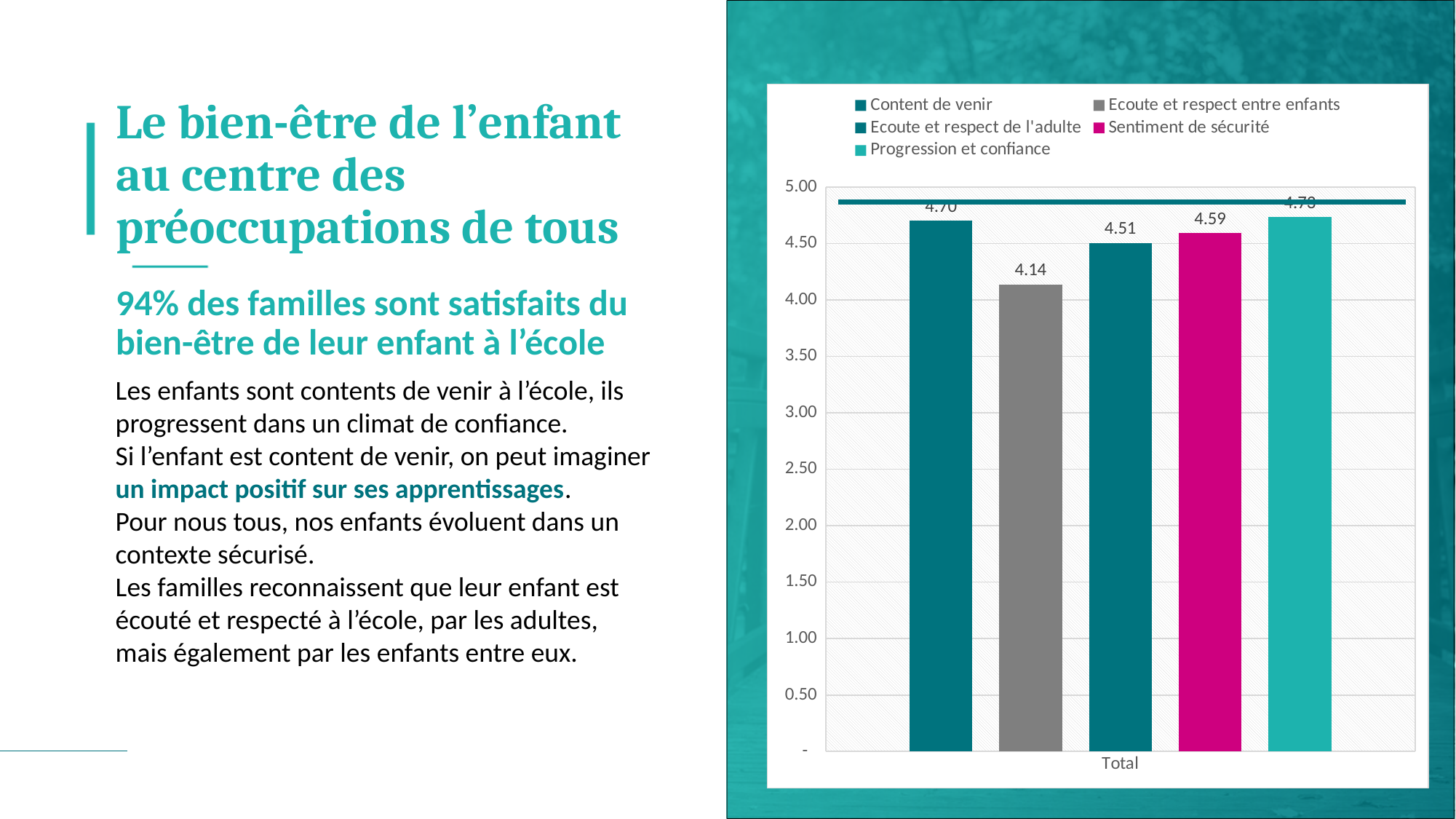
What is the label of the single category on the x axis? Total What type of chart is shown on the slide? Bar chart How many series does the chart legend list? 5 Is the value for 'Progression et confiance' greater or less than 4.50? greater What is the value for 'Ecoute et respect entre enfants'? 4.14 Which series has the lowest value in the chart? Ecoute et respect entre enfants What is the value for 'Ecoute et respect de l'adulte'? 4.51 What is the difference between the values for 'Sentiment de sécurité' and 'Ecoute et respect entre enfants'? 0.45 What is the value for 'Sentiment de sécurité'? 4.59 Which is larger, the value for 'Sentiment de sécurité' or the value for 'Ecoute et respect de l'adulte'? Sentiment de sécurité What colour is the bar for 'Sentiment de sécurité'? Pink (magenta) How many categories are shown on the x axis of the chart? 1